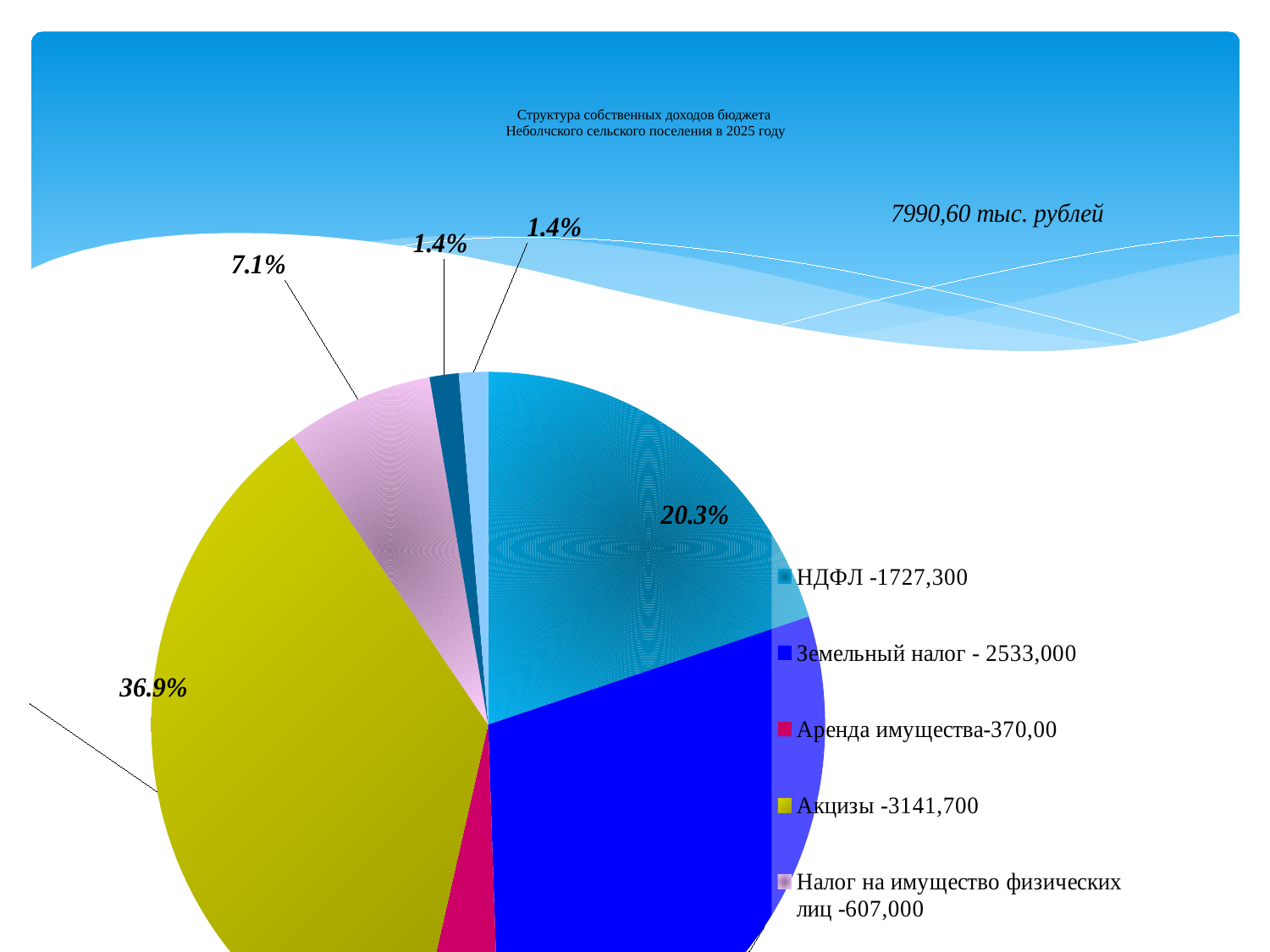
What total amount is shown on the slide for the budget's own revenues? 7990,60 тыс. рублей What kind of chart is shown on the slide? pie chart According to the legend, which is larger: Земельный налог or НДФЛ? Земельный налог What value is given for Земельный налог in the legend? 2533,000 What value is given for Аренда имущества in the legend? 370,00 By how many percentage points does the Акцизы share exceed the НДФЛ share? 16.6 What share of the pie does Налог на имущество физических лиц account for? 7.1% What share of the pie does НДФЛ account for? 20.3% What colour is the Акцизы slice in the pie chart? yellow What share of the pie does Акцизы account for? 36.9% Which category has the largest slice of the pie? Акцизы Which is larger, the slice for НДФЛ or the slice for Налог на имущество физических лиц? НДФЛ